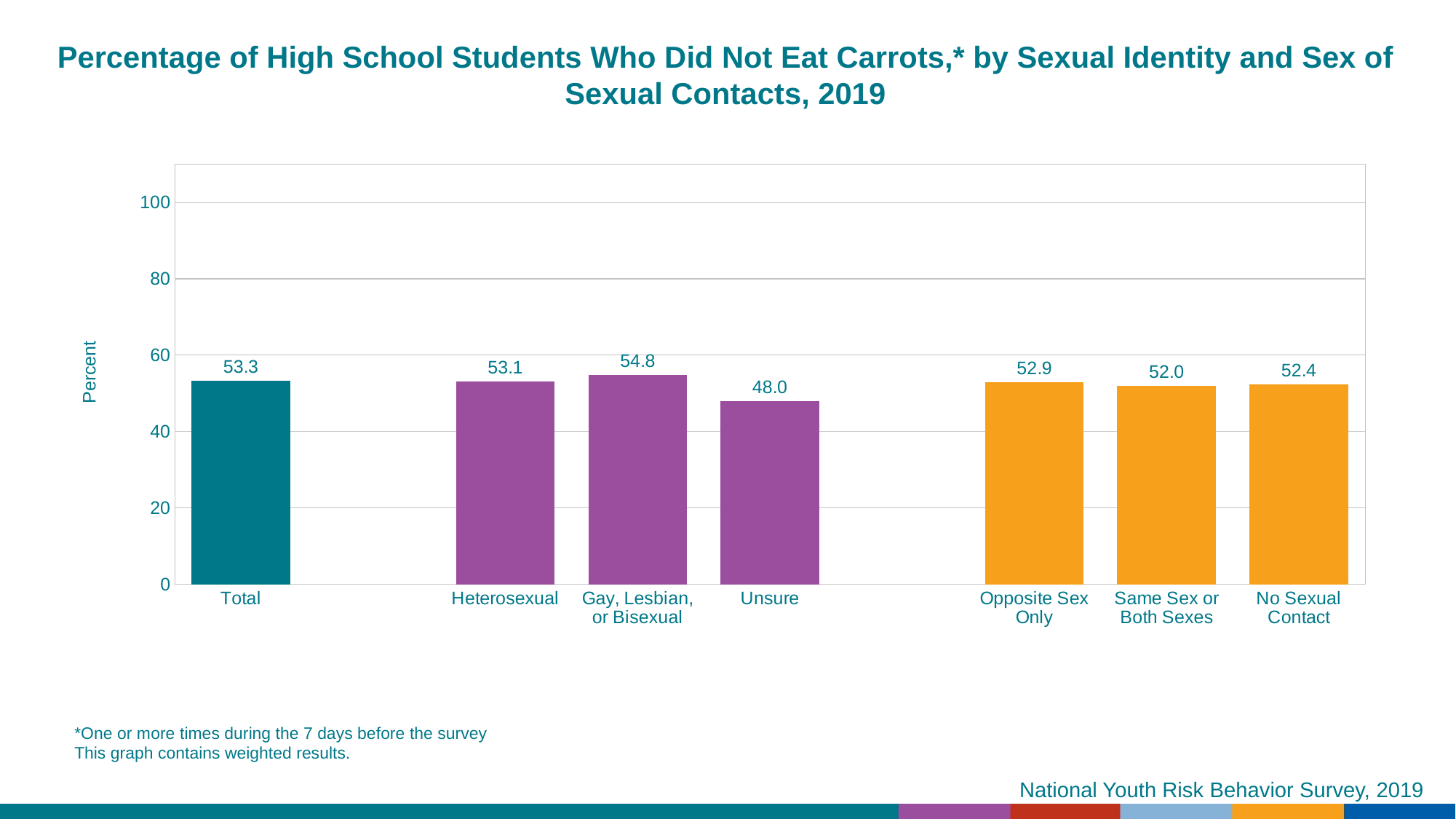
What is the difference between the values for Gay, Lesbian, or Bisexual and Unsure? 6.8 Which is larger, the value for Opposite Sex Only or the value for Unsure? Opposite Sex Only What is the value for Same Sex or Both Sexes? 52.0 How many categories are shown in the chart? 7 Which category has the lowest value? Unsure What is the difference between the values for Total and Heterosexual? 0.2 What is the value for Total? 53.3 What is the value for No Sexual Contact? 52.4 Is the value for Unsure greater or less than 60? less What is the value for Unsure? 48.0 Which category has the highest value? Gay, Lesbian, or Bisexual What kind of chart is shown on the slide? bar chart